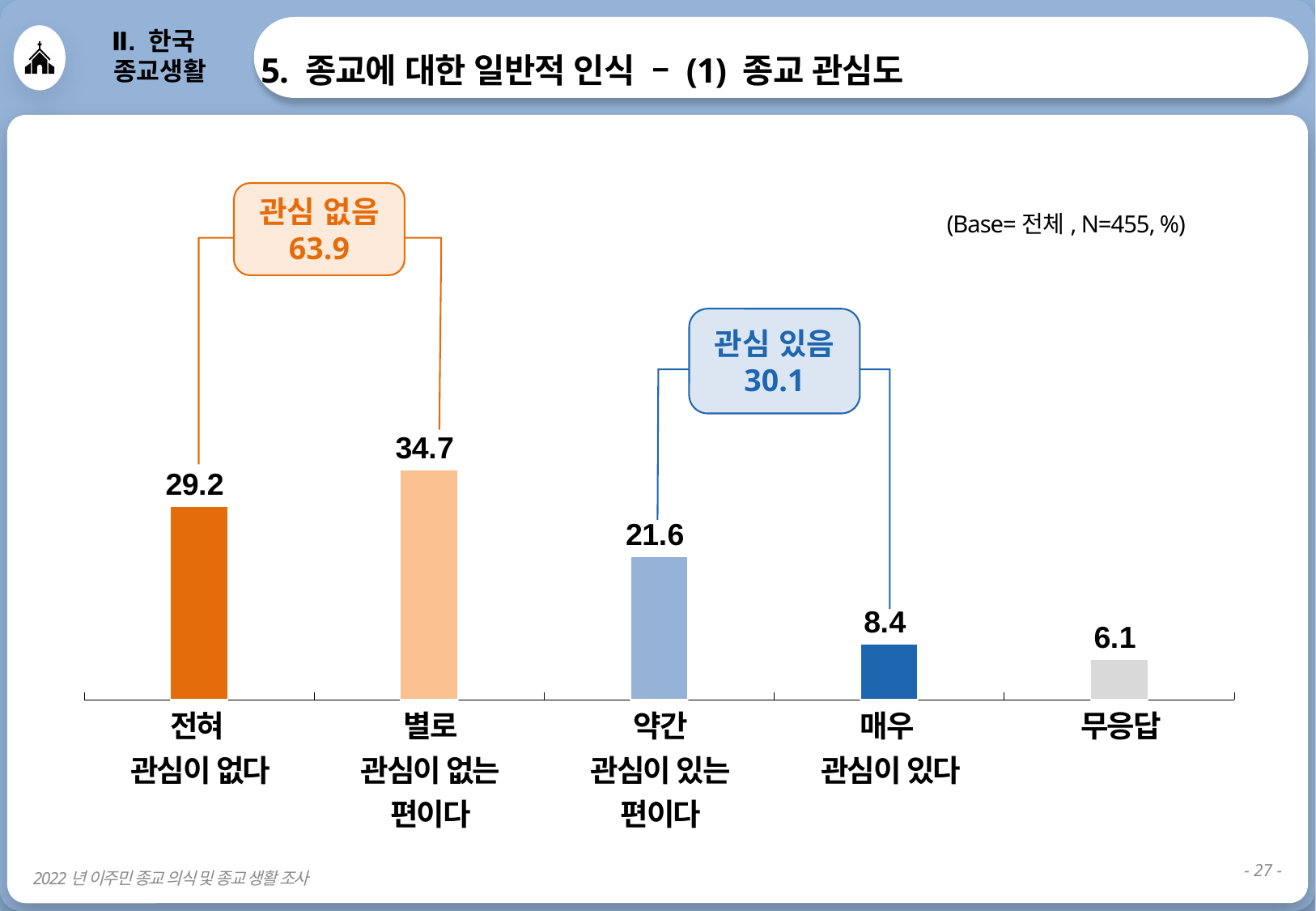
What is the difference between the values for 별로 관심이 없는 편이다 and 전혀 관심이 없다? 5.5 What is the value for 매우 관심이 있다? 8.4 Which category has the lowest value? 무응답 Which is larger, the value for 약간 관심이 있는 편이다 or the value for 매우 관심이 있다? 약간 관심이 있는 편이다 What is the value for 전혀 관심이 없다? 29.2 What is the value for 약간 관심이 있는 편이다? 21.6 How many categories are shown on the x axis? 5 What is the value for 별로 관심이 없는 편이다? 34.7 What combined value is shown in the 관심 없음 box above the chart? 63.9 Which category has the highest value? 별로 관심이 없는 편이다 What is the value for 무응답? 6.1 What kind of chart is shown on the slide? bar chart